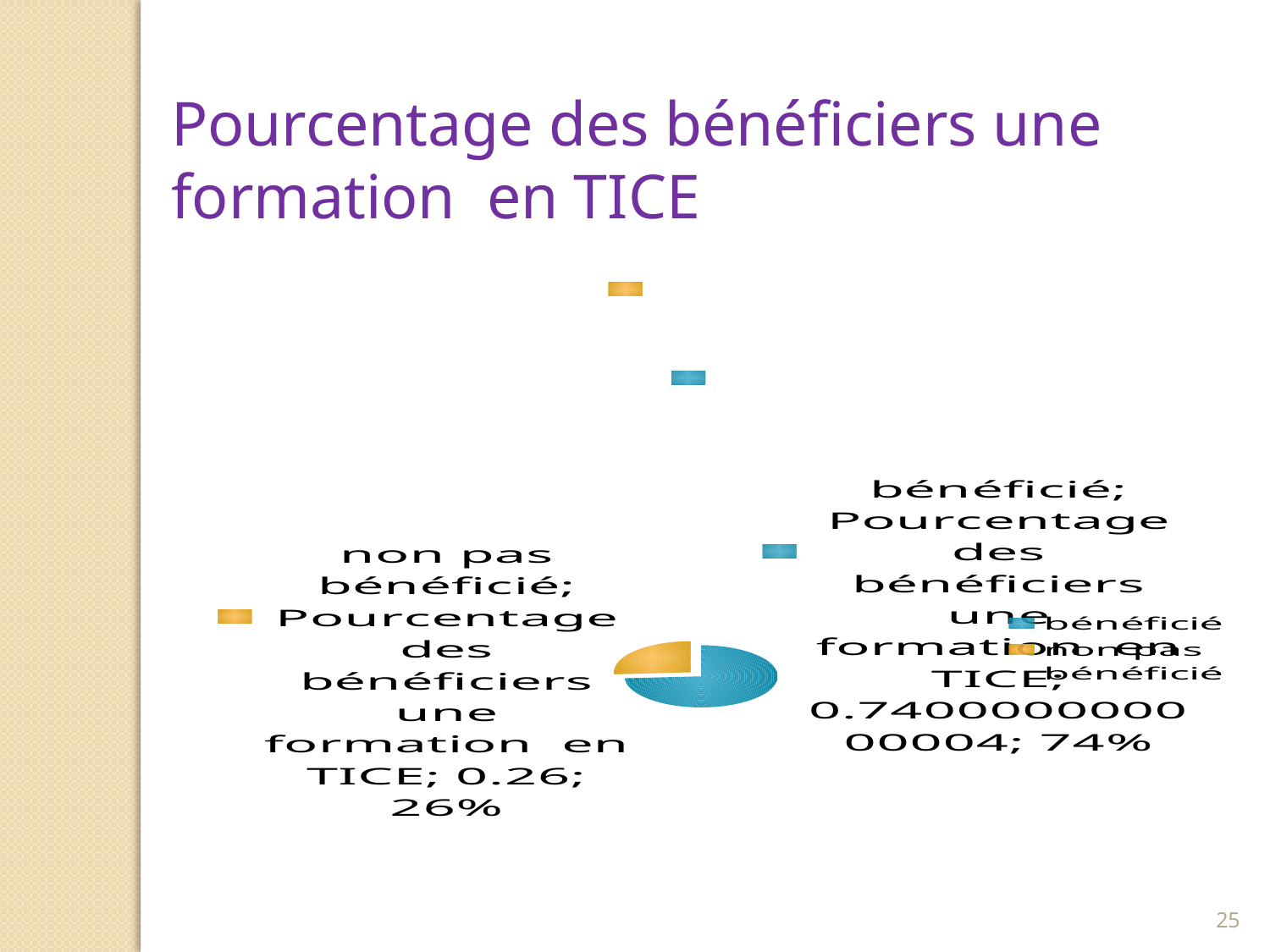
Which is larger, the "bénéficié" slice or the "non pas bénéficié" slice? bénéficié Which slice of the pie is the smallest? non pas bénéficié What percentage of the pie is the "non pas bénéficié" slice? 26% What is the title of the slide? Pourcentage des bénéficiers une formation en TICE How many slices does the pie chart have? 2 What colour is the "non pas bénéficié" slice? orange What is the difference in percentage points between the "bénéficié" and "non pas bénéficié" slices? 48% What value is printed for the "non pas bénéficié" slice? 0.26 How many entries does the legend list? 2 Which slice of the pie is the largest? bénéficié What kind of chart is shown on the slide? pie chart What percentage of the pie is the "bénéficié" slice? 74%